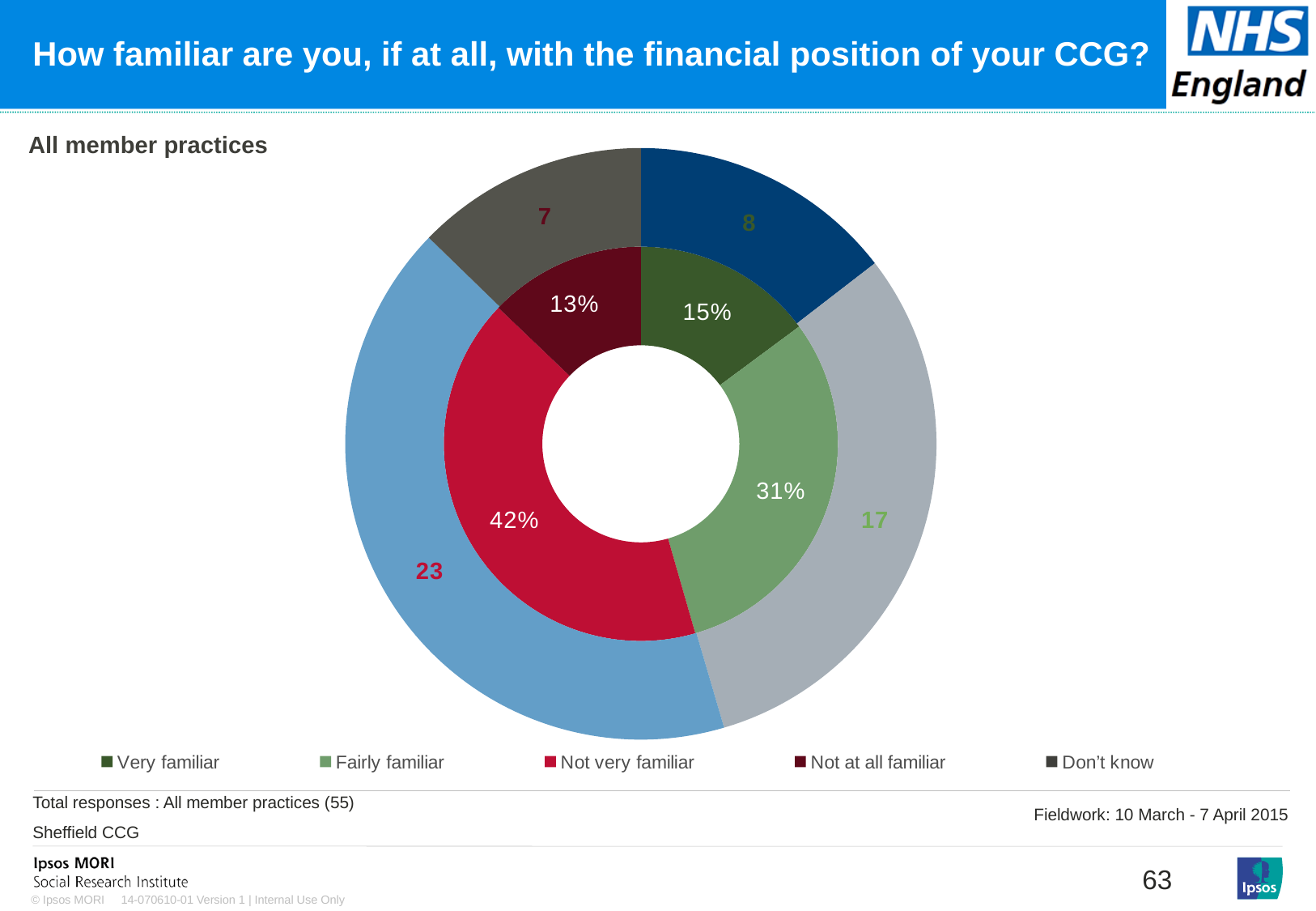
What percentage of respondents are 'Very familiar' with the financial position of their CCG? 15% Which response category has the smallest labelled share of the inner ring? Not at all familiar How many respondents (outer ring count) are 'Fairly familiar'? 17 What percentage of respondents are 'Not at all familiar'? 13% What type of chart is shown on the slide? Doughnut chart Which response category has the largest share of the inner ring? Not very familiar What percentage of respondents are 'Not very familiar' with the financial position of their CCG? 42% Which is larger: the count for 'Very familiar' or the count for 'Not at all familiar'? Very familiar How many respondents (outer ring count) are 'Not very familiar'? 23 How many categories does the legend list? 5 What percentage of respondents are 'Fairly familiar'? 31% What is the difference in percentage points between 'Not very familiar' and 'Fairly familiar'? 11